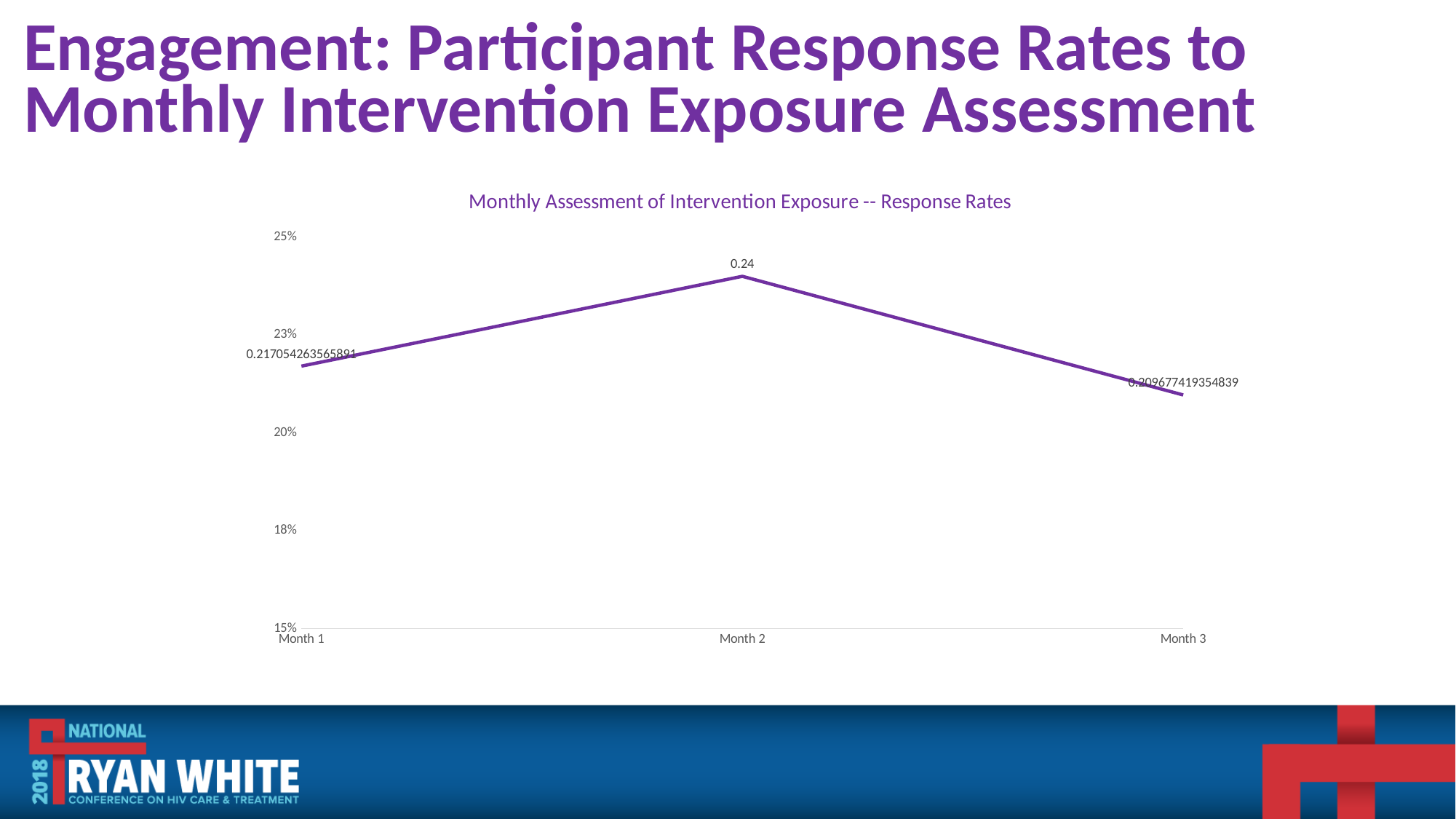
What is the title of the chart? Monthly Assessment of Intervention Exposure -- Response Rates What kind of chart is shown on the slide? line chart Is the value for Month 3 greater or less than 20%? greater What is the value plotted for Month 1? 0.217054263565891 Is the value for Month 1 greater or less than 23%? less Which month has the highest response rate? Month 2 What is the value plotted for Month 3? 0.209677419354839 What is the value plotted for Month 2? 0.24 How many months are plotted on the x axis? 3 Does the response rate rise or fall from Month 2 to Month 3? fall Which month has the lowest response rate? Month 3 Which is larger, the value for Month 1 or the value for Month 3? Month 1